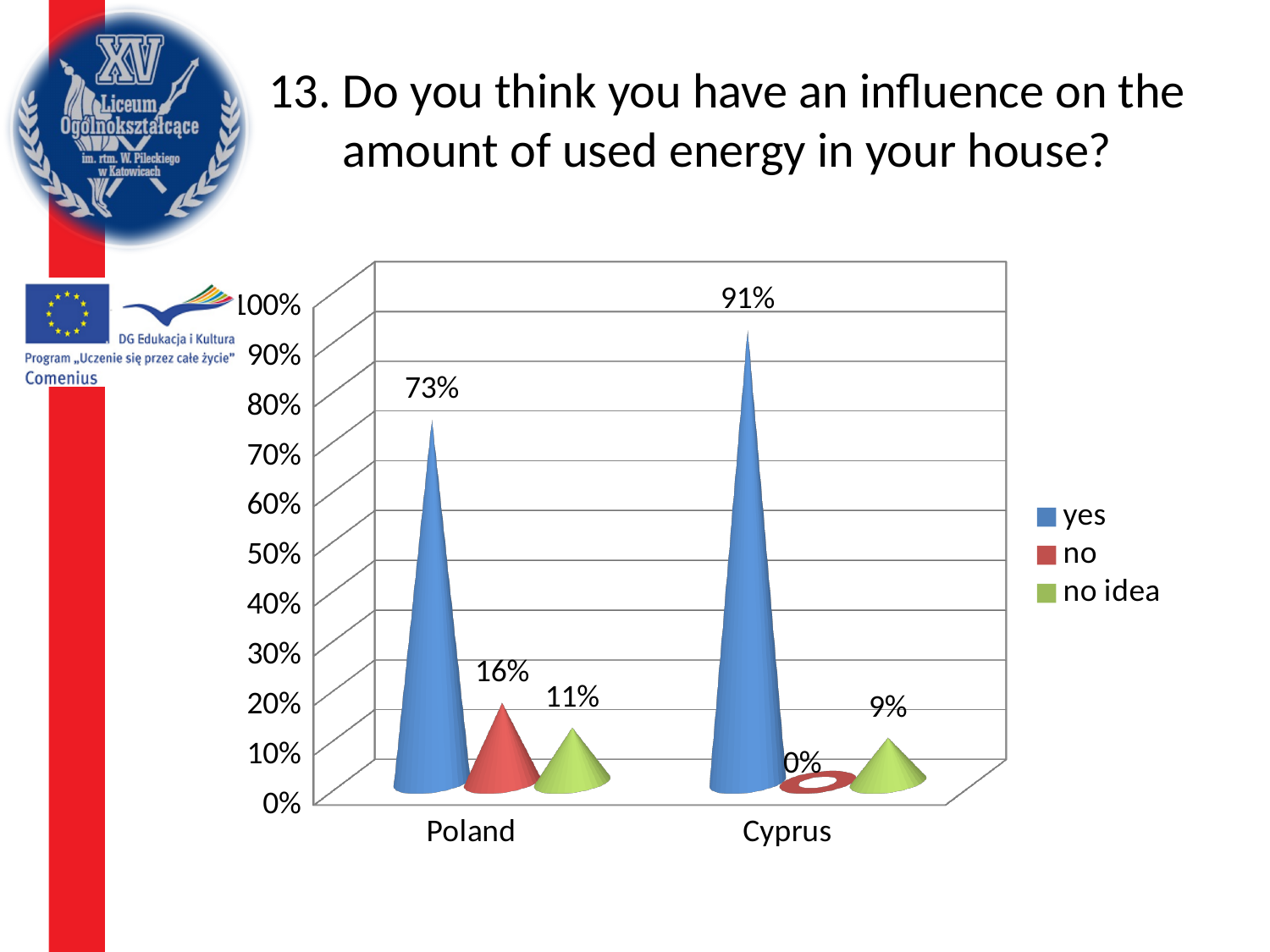
How many countries are shown on the x axis? 2 What percentage of respondents in Cyprus answered "yes"? 91% What is the difference between the "yes" values for Cyprus and Poland? 18% Which country has the higher "yes" value? Cyprus What percentage of respondents in Poland answered "no"? 16% How many series does the legend list? 3 What is the difference between the "no" and "no idea" values for Poland? 5% What percentage of respondents in Poland answered "yes"? 73% Which answer has the lowest value for Poland? no idea Which colour represents the "no idea" series in the legend? green What percentage of respondents in Cyprus answered "no idea"? 9% What percentage of respondents in Cyprus answered "no"? 0%